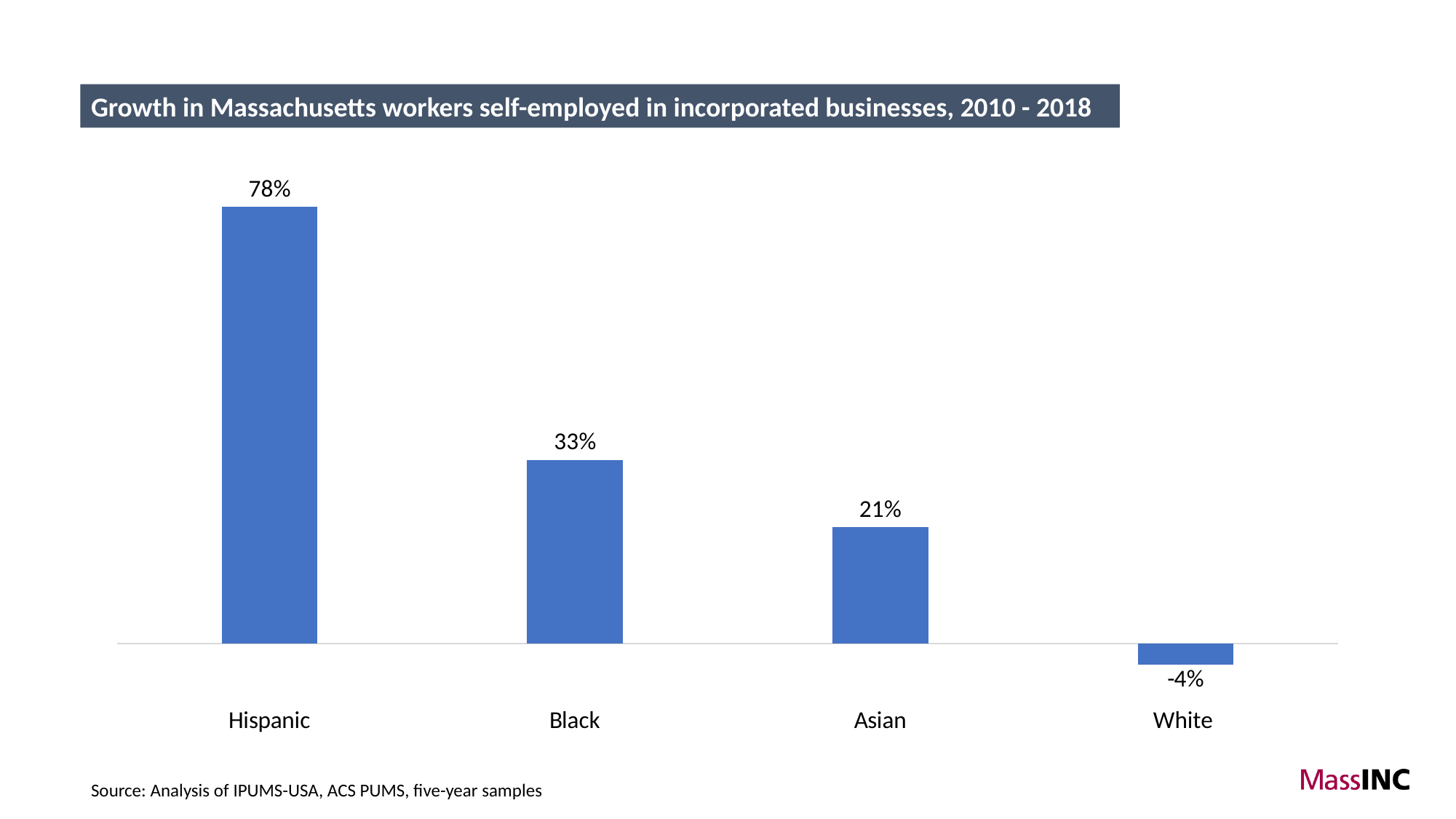
What is the difference between the growth for Hispanic and Black workers? 45% What is the growth value for Asian workers? 21% What kind of chart is shown on the slide? Bar chart How many groups are shown in the chart? 4 Which group has the lowest growth? White Which is larger, the growth for Asian workers or for White workers? Asian Which group has the highest growth? Hispanic What is the growth value for Hispanic workers? 78% What is the growth value for Black workers? 33% What is the growth value for White workers? -4% What is the difference between the growth for Black and Asian workers? 12% What is the title of the chart? Growth in Massachusetts workers self-employed in incorporated businesses, 2010 - 2018